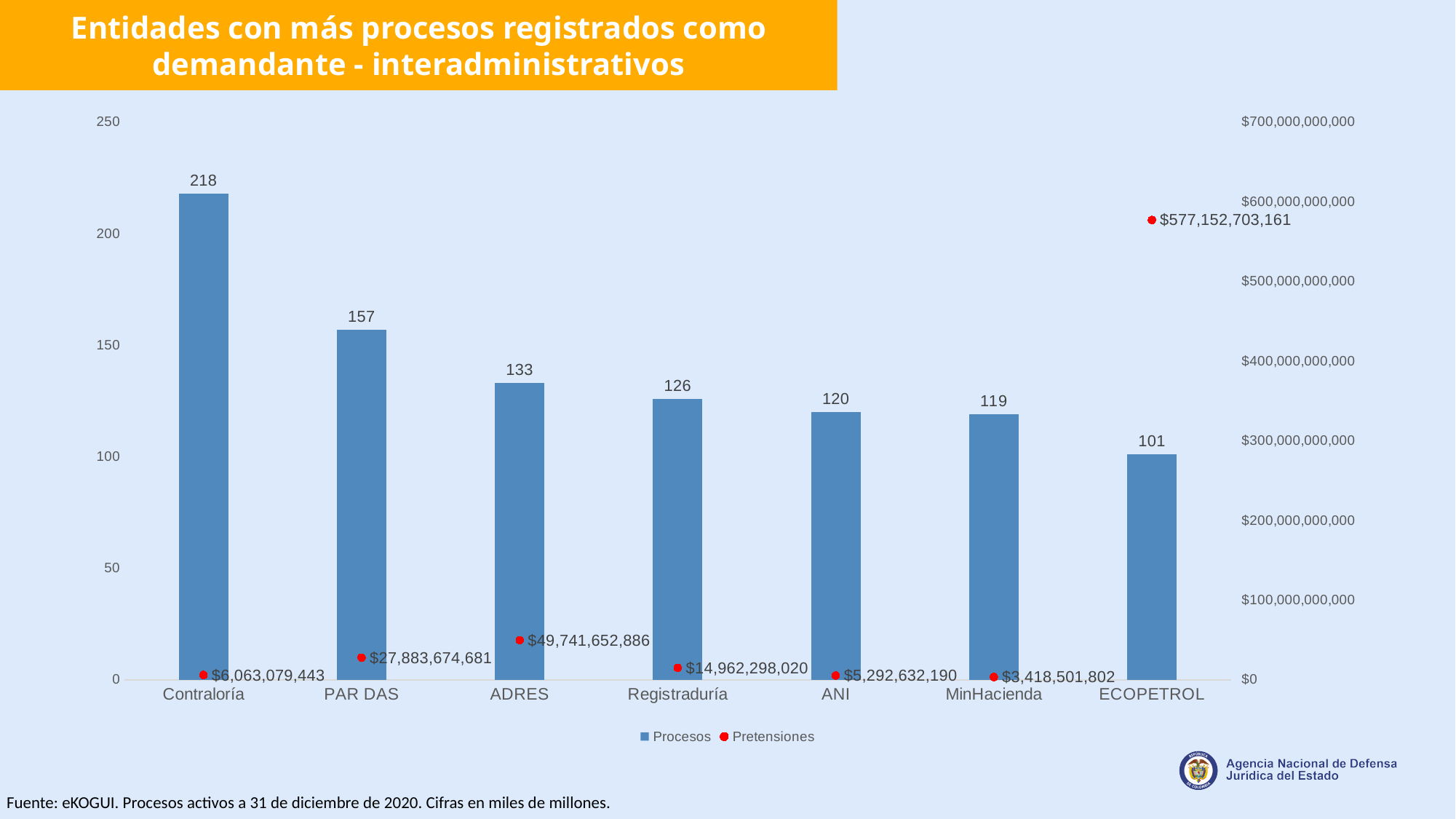
Do the Procesos values rise or fall from left to right along the x axis? fall How many series does the legend list? 2 How many Procesos are shown for Contraloría? 218 Which entity has the highest number of Procesos? Contraloría What is the Pretensiones value for ADRES? $49,741,652,886 How many Procesos are shown for MinHacienda? 119 What is the Pretensiones value for ECOPETROL? $577,152,703,161 What is the difference in Procesos between Contraloría and PAR DAS? 61 How many entities are shown on the x axis? 7 What colour are the Pretensiones markers? red Which has more Procesos, ADRES or Registraduría? ADRES Which entity has the lowest Pretensiones value? MinHacienda